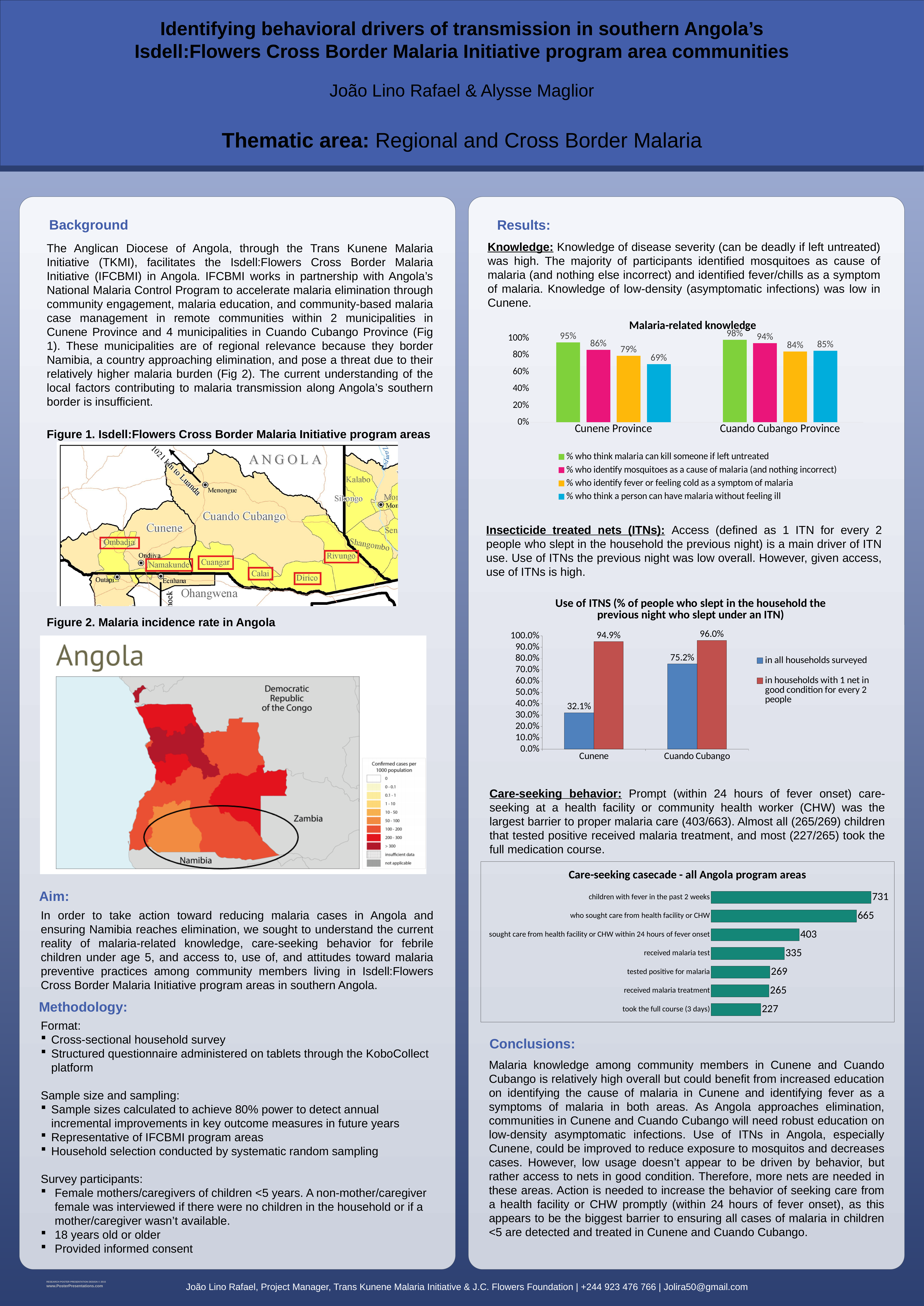
In the 'Malaria-related knowledge' chart, what percentage of Cuando Cubango Province participants identify mosquitoes as a cause of malaria (and nothing incorrect)? 94% In the 'Malaria-related knowledge' chart, what is the difference between the two provinces for '% who identify fever or feeling cold as a symptom of malaria'? 5% In the 'Malaria-related knowledge' chart, which province has the lower value for '% who think a person can have malaria without feeling ill'? Cunene Province In the 'Care-seeking casecade' chart, what is the difference between 'children with fever in the past 2 weeks' and 'who sought care from health facility or CHW'? 66 In the 'Use of ITNS' chart, what is the value for Cuando Cubango in households with 1 net in good condition for every 2 people? 96.0% In the 'Use of ITNS' chart, what is the difference between the two bars for Cunene? 62.8% In the 'Use of ITNS' chart, which is larger: Cunene in all households surveyed or Cuando Cubango in all households surveyed? Cuando Cubango How many series does the legend of the 'Malaria-related knowledge' chart list? 4 In the 'Use of ITNS' chart, what is the value for Cunene in all households surveyed? 32.1% What type of chart is the 'Care-seeking casecade - all Angola program areas' chart? Bar chart In the 'Malaria-related knowledge' chart, what percentage of Cunene Province participants think malaria can kill someone if left untreated? 95% In the 'Care-seeking casecade' chart, how many children sought care from a health facility or CHW within 24 hours of fever onset? 403